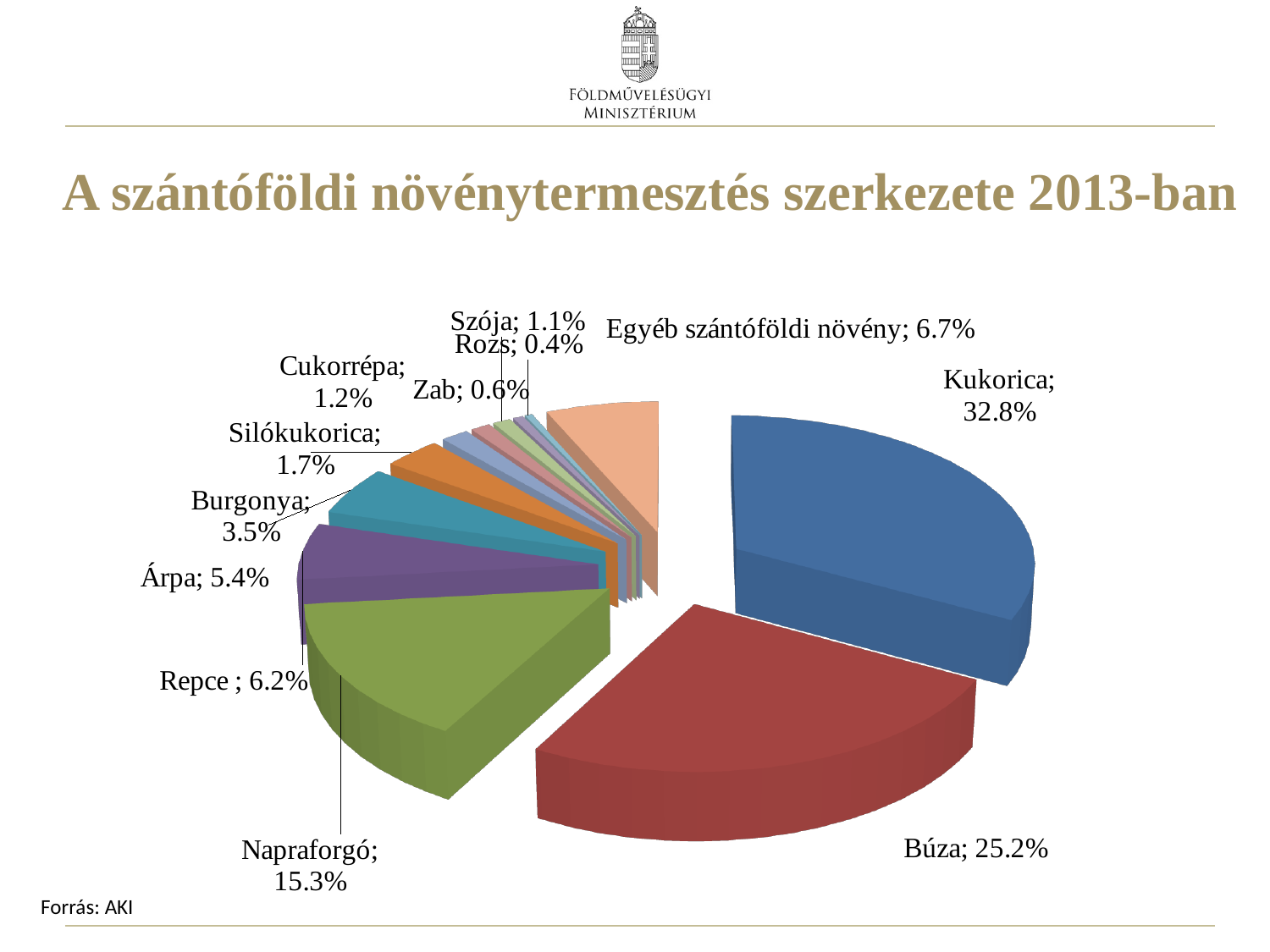
What kind of chart is shown on the slide? Pie chart What is the value shown for Napraforgó? 15.3% What is the value shown for Búza? 25.2% How many categories are shown in the pie chart? 12 What is the difference between the shares of Burgonya and Silókukorica? 1.8% What is the title of the chart on the slide? A szántóföldi növénytermesztés szerkezete 2013-ban What share of the pie does Kukorica have? 32.8% What is the value shown for Egyéb szántóföldi növény? 6.7% Which category has the largest slice of the pie? Kukorica Which is larger, the share of Repce or the share of Árpa? Repce What is the difference between the shares of Kukorica and Búza? 7.6% Which category has the smallest slice of the pie? Rozs